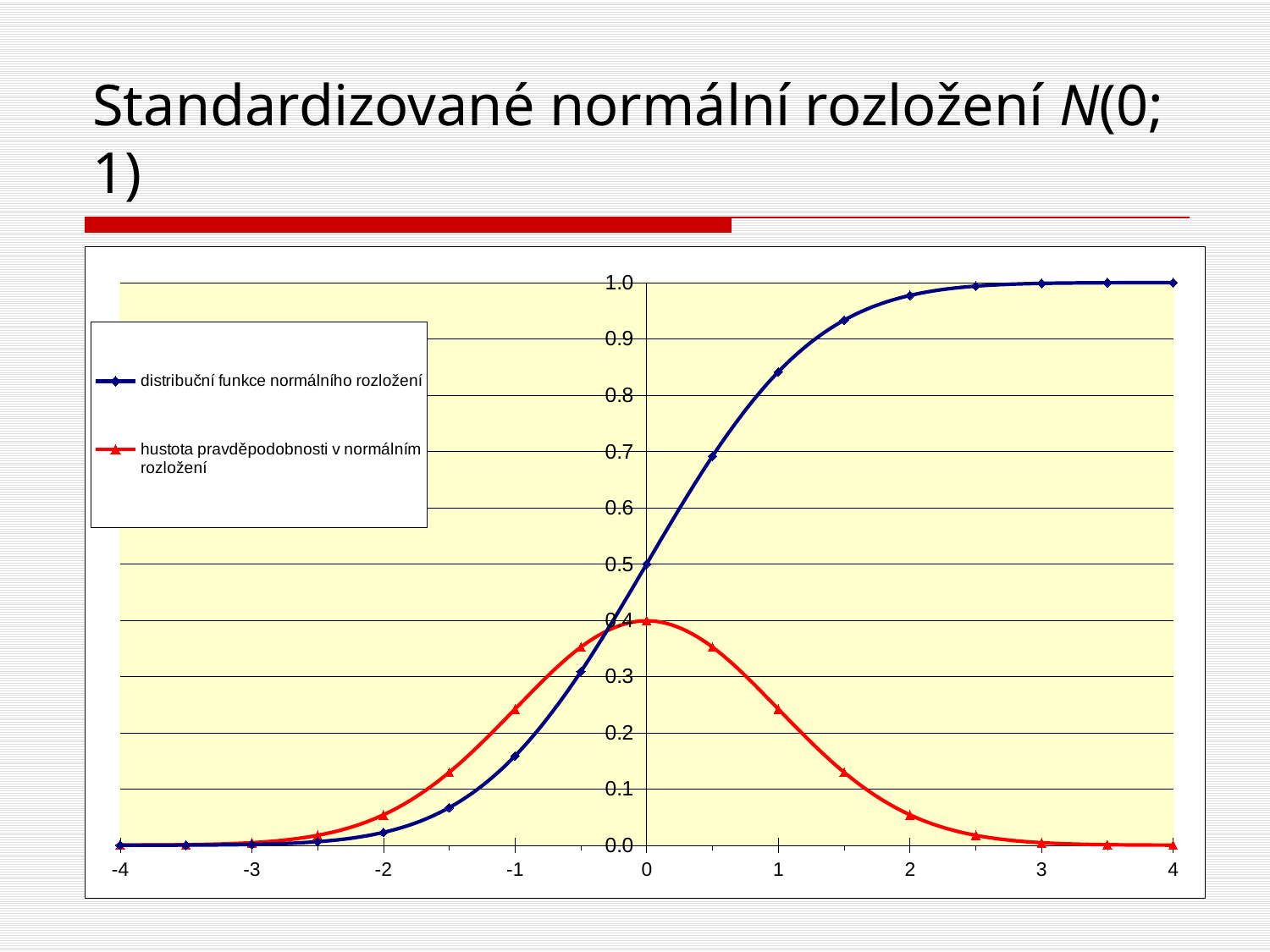
How many series does the legend list? 2 Is the value of the distribuční funkce normálního rozložení series at x = 1 greater or less than 0.8? greater Does the distribuční funkce normálního rozložení series rise or fall as x increases from -4 to 4? rise At x = 1, which series has the higher value? distribuční funkce normálního rozložení Which series is drawn in blue with diamond markers? distribuční funkce normálního rozložení Is the value of the distribuční funkce normálního rozložení series at x = -1 greater or less than 0.2? less What is the value of the distribuční funkce normálního rozložení series at x = 0? 0.5 At which x value does the hustota pravděpodobnosti v normálním rozložení series reach its maximum? 0 What kind of chart is shown on the slide? line chart Which series is drawn in red with triangle markers? hustota pravděpodobnosti v normálním rozložení Is the value of the hustota pravděpodobnosti v normálním rozložení series at x = 2 greater or less than 0.1? less